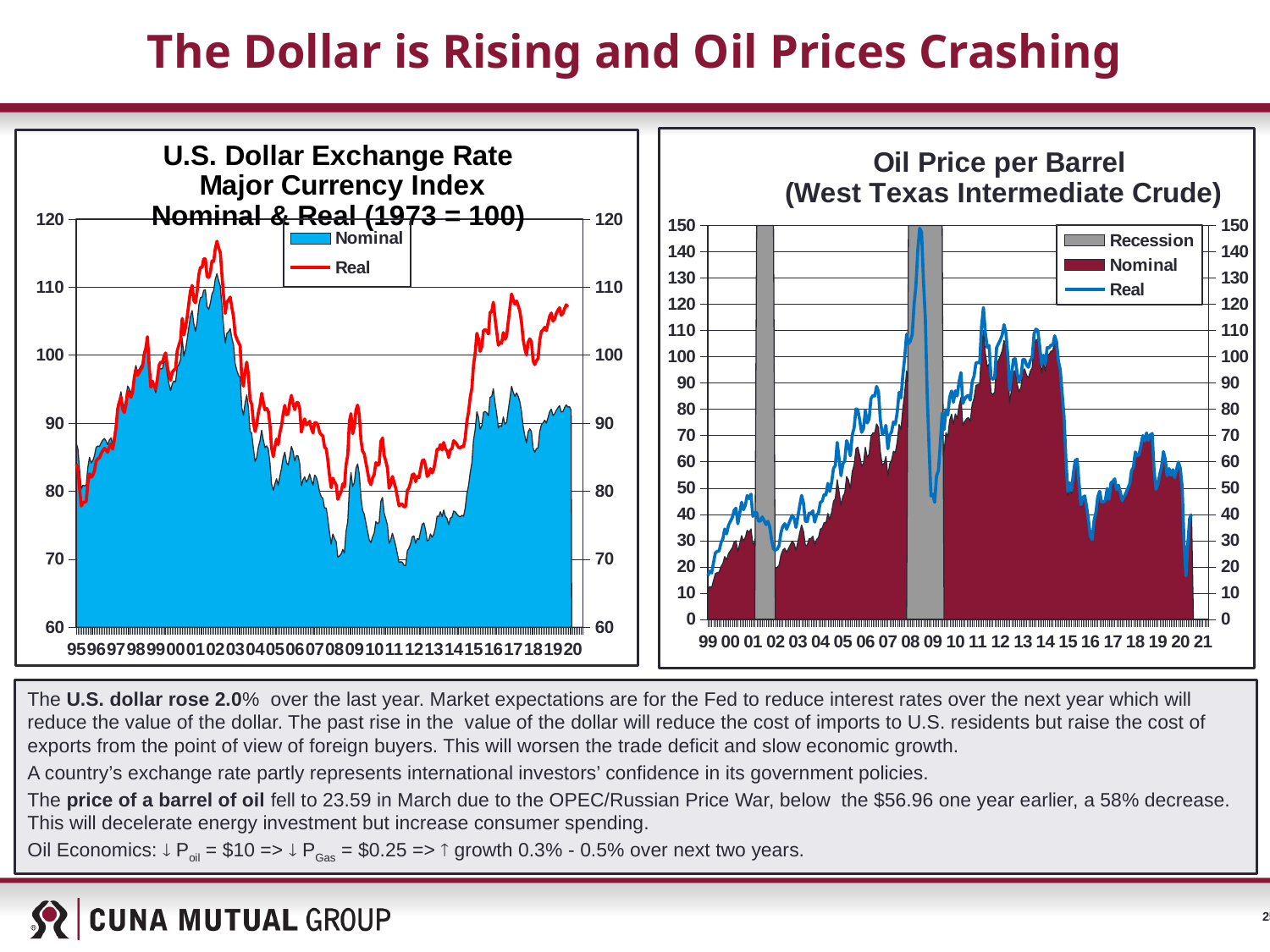
How many entries does the legend of the right chart (Oil Price per Barrel) list? 3 In the Oil Price per Barrel chart, what does the gray shading represent according to the legend? Recession In the Oil Price per Barrel chart, does the Nominal oil price rise or fall between 1999 and 2008? rise What is the subtitle in parentheses of the right chart, Oil Price per Barrel? West Texas Intermediate Crude In the U.S. Dollar Exchange Rate chart, is the Real index at its 2002 peak greater or less than 110? greater In the Oil Price per Barrel chart, does the Nominal oil price rise or fall between 2014 and 2016? fall How many series does the legend of the left chart (U.S. Dollar Exchange Rate) list? 2 In the Oil Price per Barrel chart, is the Nominal oil price at the start of 1999 greater or less than 30? less In the U.S. Dollar Exchange Rate chart, does the Nominal index rise or fall between 1995 and 2002? rise In the U.S. Dollar Exchange Rate chart, is the Nominal index at its 2008 low greater or less than 80? less